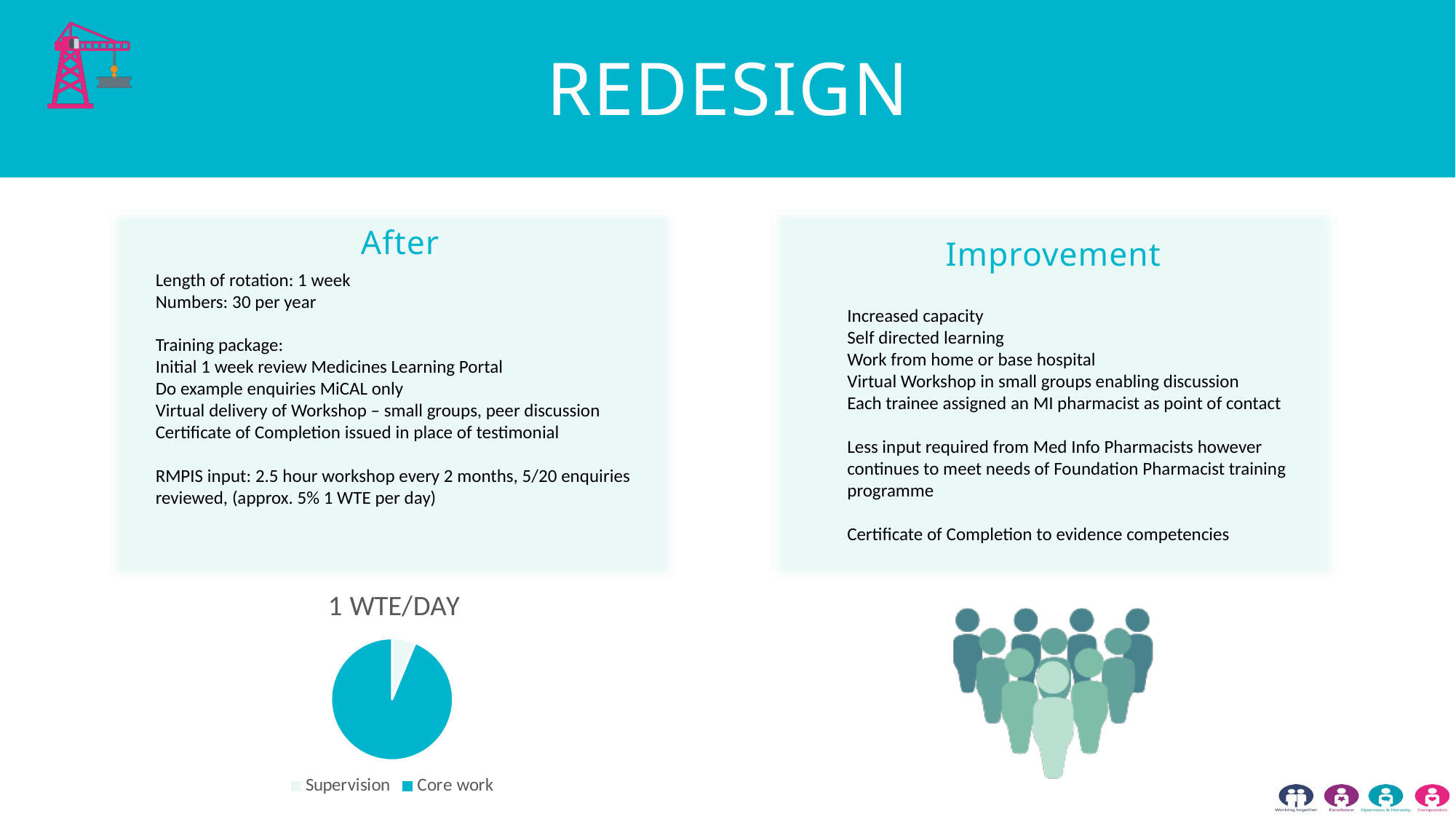
What kind of chart is shown under the heading "1 WTE/DAY"? Pie chart What is the title of the pie chart on the slide? 1 WTE/DAY How many entries does the legend of the pie chart list? 2 How many slices does the pie chart have? 2 Which slice of the pie chart is the largest? Core work What are the two categories listed in the pie chart's legend? Supervision and Core work In the pie chart, which is larger: Supervision or Core work? Core work Which slice of the pie chart is the smallest? Supervision